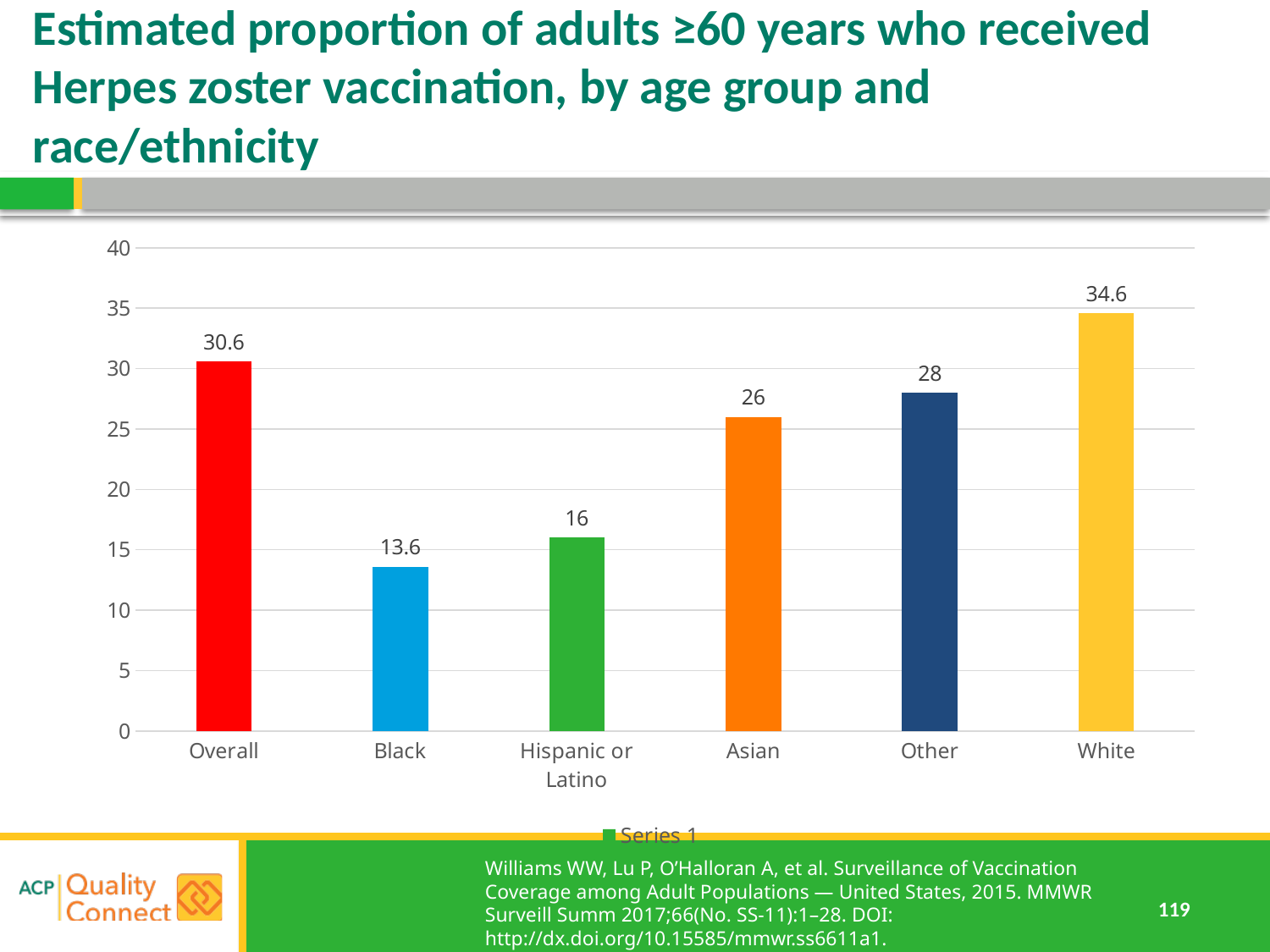
Which category has the highest value? White What kind of chart is shown on the slide? Bar chart What is the value for White? 34.6 What colour is the bar for Asian? Orange What is the value for Black? 13.6 Which category has the lowest value? Black Which is larger, the value for Asian or the value for Other? Other How many categories are shown on the x axis? 6 What is the value for Overall? 30.6 What is the difference between the values for Other and Asian? 2 What is the value for Hispanic or Latino? 16 What is the difference between the values for White and Black? 21